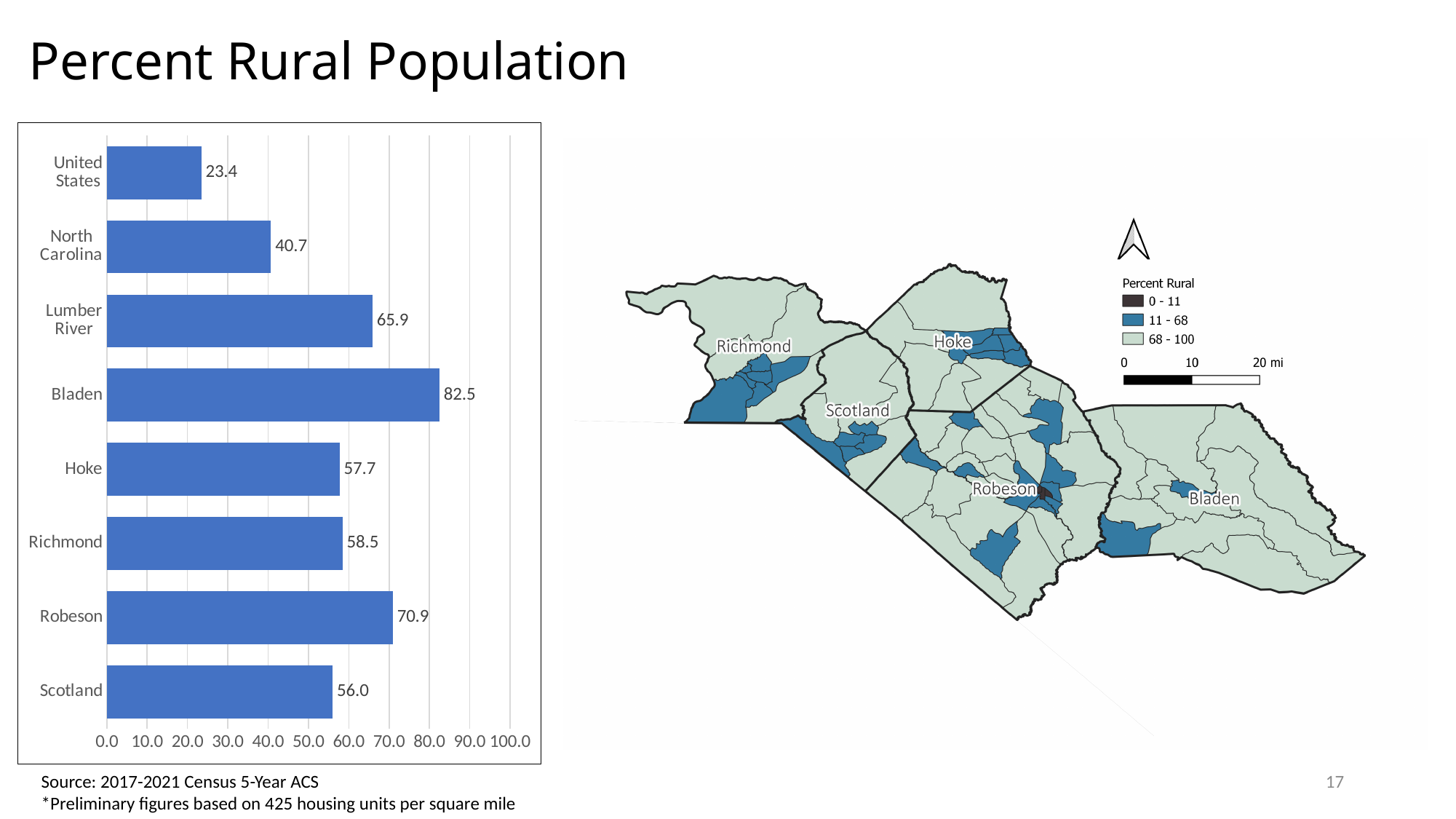
Which category has the highest value in the bar chart? Bladen What is the value shown for Lumber River in the bar chart? 65.9 Which has a larger value in the bar chart, Hoke or Richmond? Richmond What is the value shown for the United States in the bar chart? 23.4 What is the difference between the values for Robeson and Scotland in the bar chart? 14.9 What kind of chart is shown on the left of the slide? Bar chart How many categories are shown in the bar chart? 8 Is the value for Robeson in the bar chart greater or less than 60.0? greater What is the difference between the values for North Carolina and the United States in the bar chart? 17.3 Which category has the lowest value in the bar chart? United States What is the title of the slide? Percent Rural Population What is the percent rural population value shown for Bladen in the bar chart? 82.5